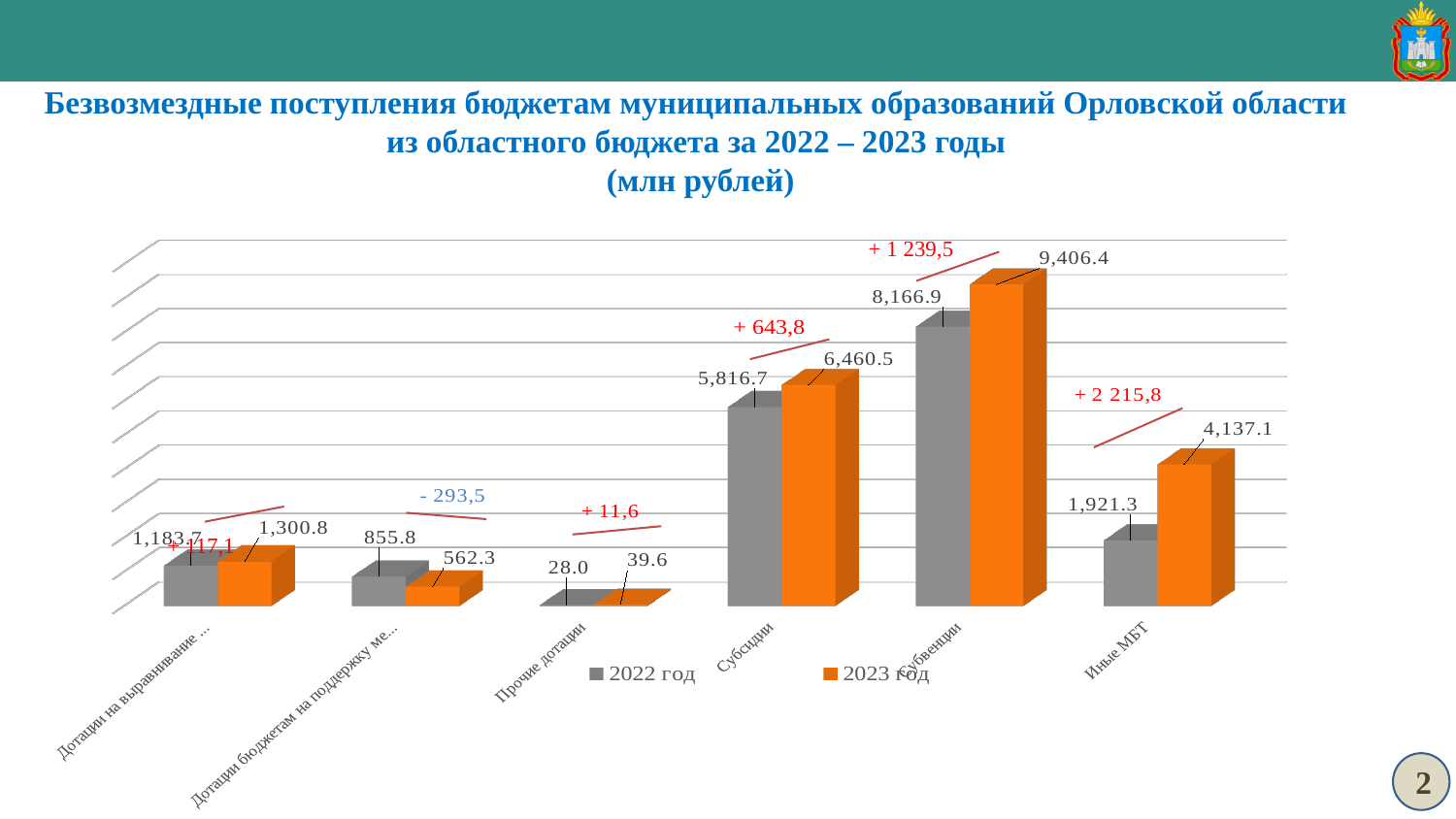
How many categories are shown on the x axis? 6 What is the value for Иные МБТ in the 2022 год series? 1,921.3 What is the value for Субсидии in the 2022 год series? 5,816.7 What kind of chart is shown on the slide? Bar chart What is the value for Прочие дотации in the 2023 год series? 39.6 Which category has the lowest value in the 2022 год series? Прочие дотации What is the difference between the 2023 год and 2022 год values for Иные МБТ? 2,215.8 What is the value for Субвенции in the 2023 год series? 9,406.4 For Субсидии, which series has the larger value, 2022 год or 2023 год? 2023 год Which category has the highest value in the 2023 год series? Субвенции How many series does the legend list? 2 By how much did the value for Субвенции increase from 2022 год to 2023 год? 1,239.5